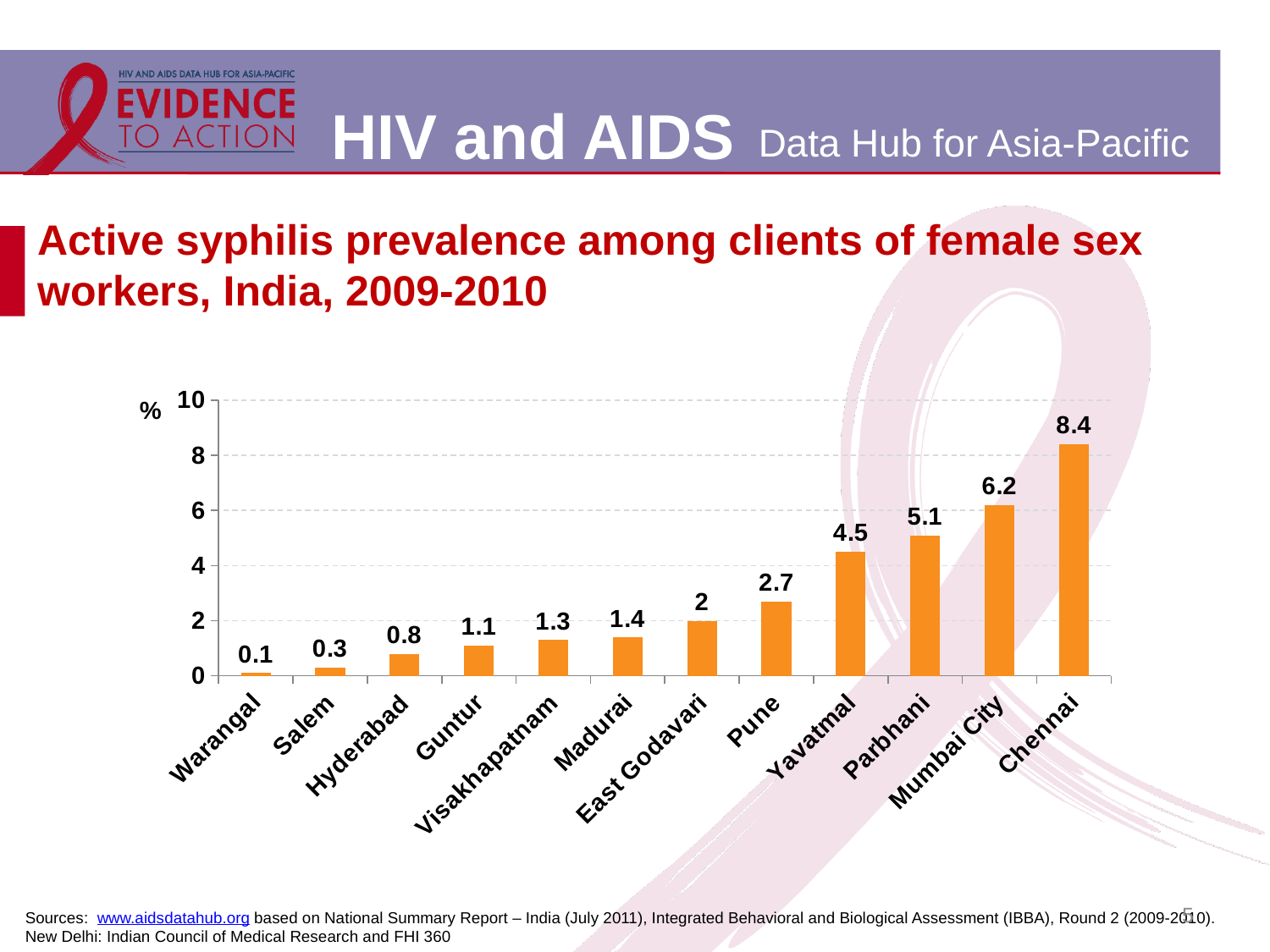
What is the value shown for Pune? 2.7 Do the values rise or fall from left to right along the x axis? Rise Which has a higher value, Hyderabad or Madurai? Madurai How many cities are shown on the chart? 12 What is the active syphilis prevalence for Chennai? 8.4 What is the difference between the values for Chennai and Mumbai City? 2.2 Which city has the highest active syphilis prevalence? Chennai What is the difference between the values for Parbhani and Yavatmal? 0.6 Is the value for Mumbai City greater or less than 4? greater What is the value shown for Warangal? 0.1 What kind of chart is shown on the slide? Bar chart Which city has the lowest active syphilis prevalence? Warangal